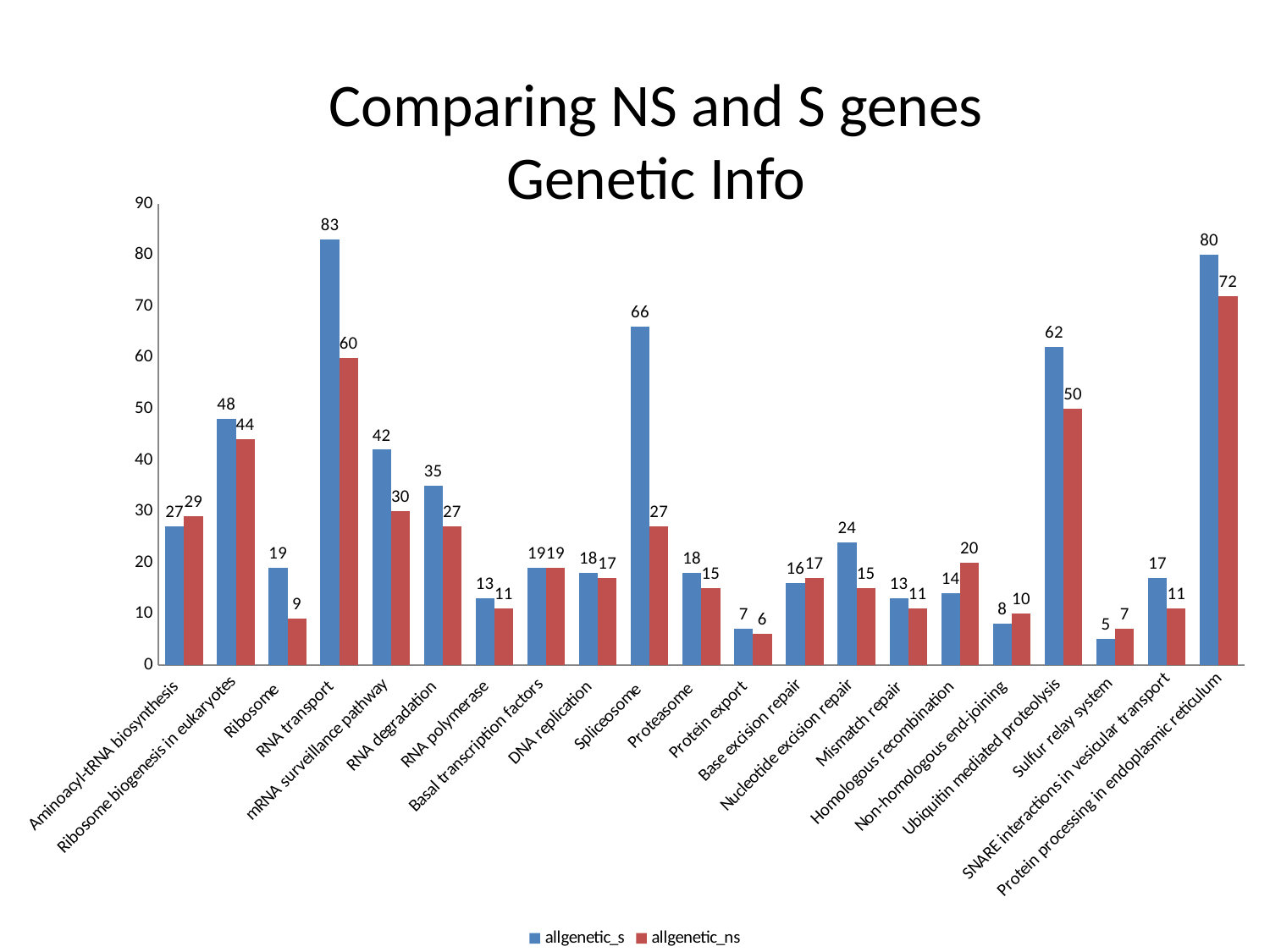
Which is larger for Homologous recombination, allgenetic_s or allgenetic_ns? allgenetic_ns What is the allgenetic_ns value for Spliceosome? 27 What is the allgenetic_s value for RNA transport? 83 What is the title of the chart? Comparing NS and S genes Genetic Info What kind of chart is shown on the slide? Bar chart Which category has the lowest allgenetic_s value? Sulfur relay system How many categories are shown on the x axis? 21 What is the allgenetic_ns value for Ubiquitin mediated proteolysis? 50 How many series does the legend list? 2 Which category has the highest allgenetic_s value? RNA transport Which category has the highest allgenetic_ns value? Protein processing in endoplasmic reticulum What is the difference between the allgenetic_s and allgenetic_ns values for Spliceosome? 39